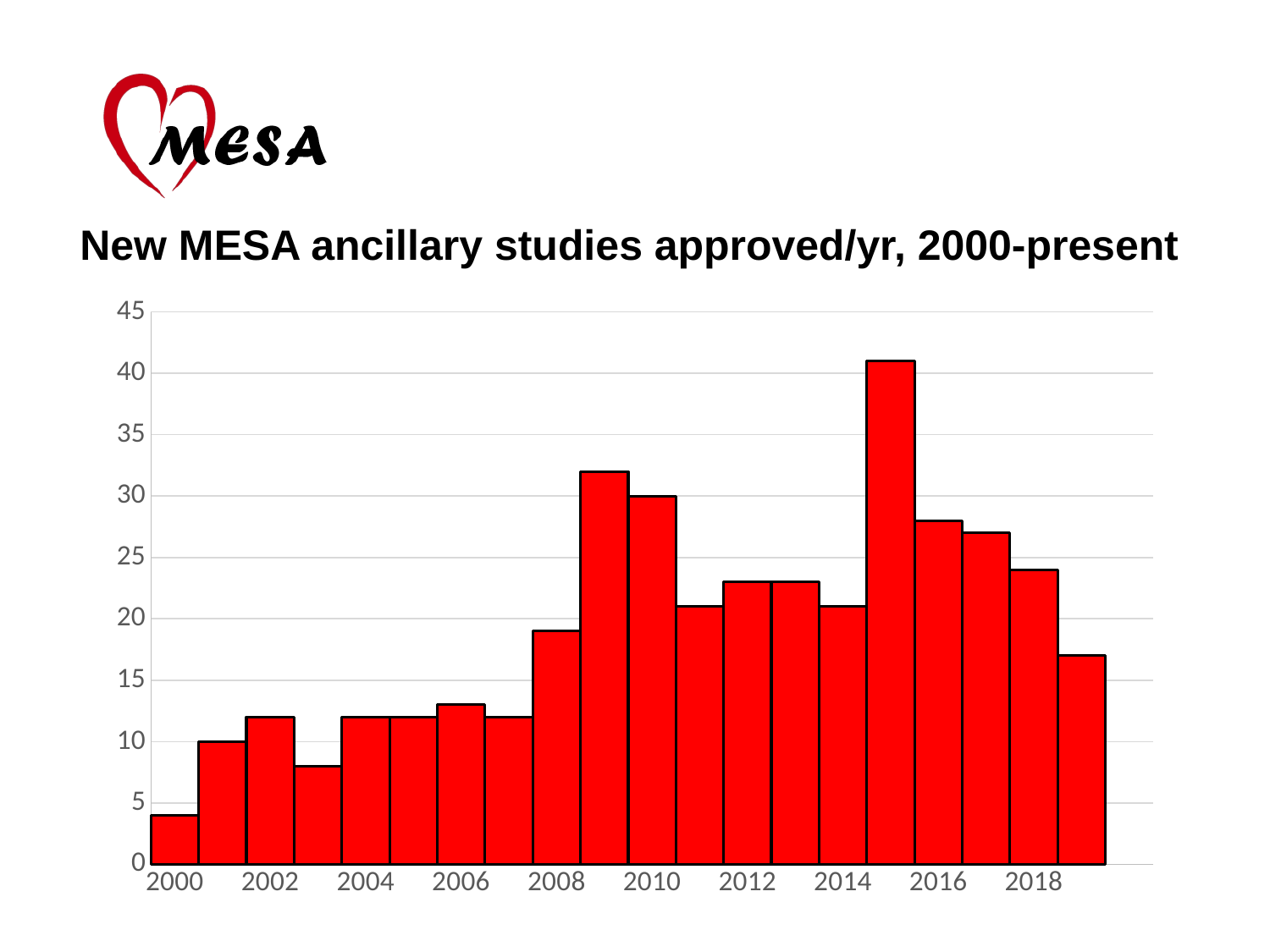
Do the values rise or fall from 2015 to 2019? fall Is the value for 2000 greater or less than 5? less Which year has a higher value, 2015 or 2009? 2015 Is the value for 2015 greater or less than 40? greater What kind of chart is shown on the slide? Bar chart Which year has the lowest number of new ancillary studies approved? 2000 What is the title of the chart? New MESA ancillary studies approved/yr, 2000-present How many bars (years) are plotted in the chart? 20 Is the value for 2003 greater or less than 10? less Which year has the highest number of new ancillary studies approved? 2015